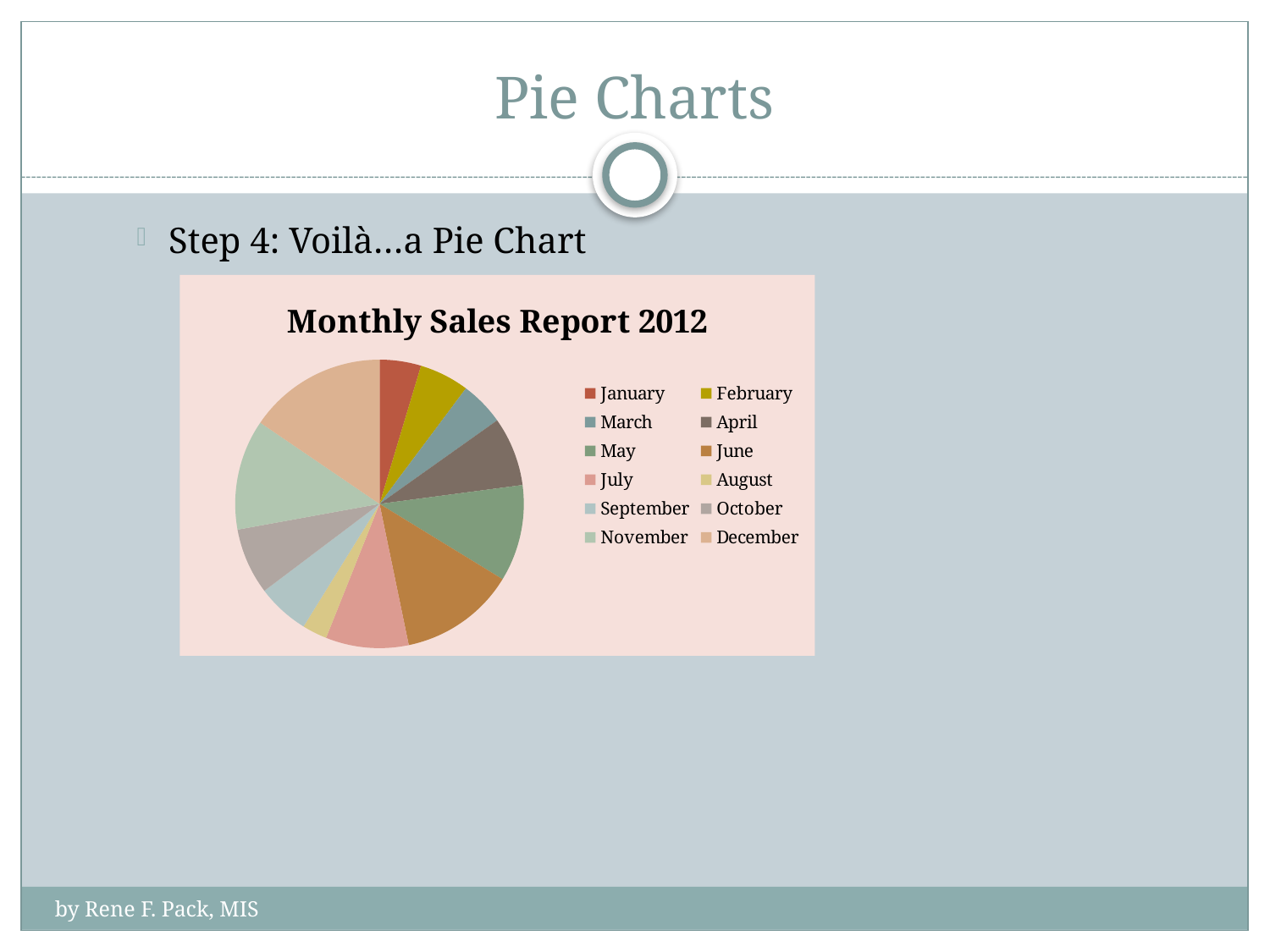
Which slice is larger, March or May? May What kind of chart is shown on the slide? pie chart Which slice is larger, August or November? November Which slice is larger, January or June? June Which month is listed first in the chart's legend? January How many slices (categories) does the pie chart have? 12 Which month has the smallest slice in the pie chart? August What is the title of the chart? Monthly Sales Report 2012